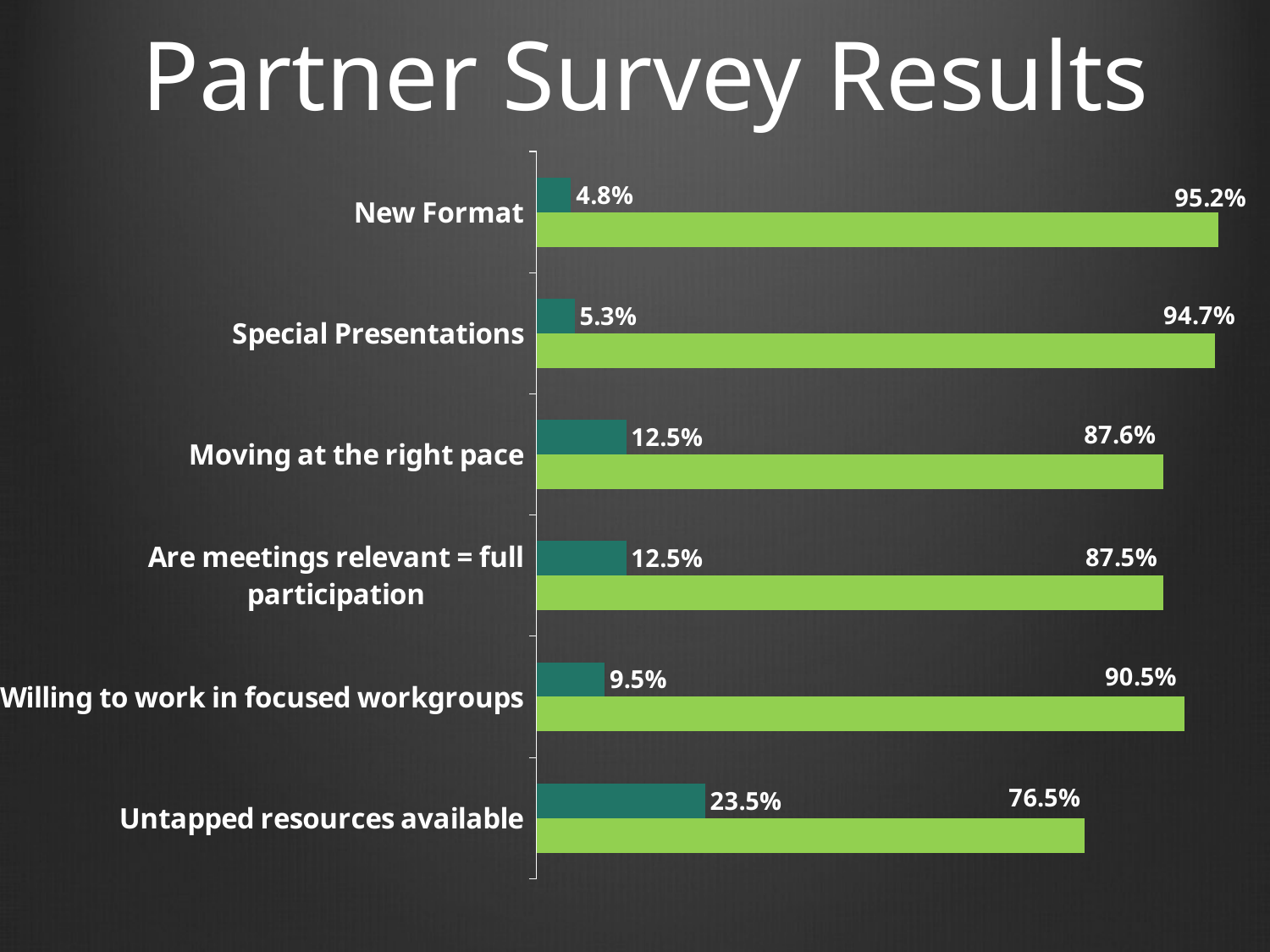
What kind of chart is shown on the slide? bar chart What is the dark teal bar value for Special Presentations? 5.3% Which category has the highest light green bar value? New Format What is the light green bar value for Willing to work in focused workgroups? 90.5% What is the difference between the light green and dark teal values for Moving at the right pace? 75.1% What is the title of the slide containing the chart? Partner Survey Results What is the dark teal bar value for Untapped resources available? 23.5% Which category has the highest dark teal bar value? Untapped resources available How many categories does the chart show? 6 Which is larger: the dark teal value for Untapped resources available or the dark teal value for Willing to work in focused workgroups? Untapped resources available Which category has the lowest light green bar value? Untapped resources available What is the light green bar value for New Format? 95.2%